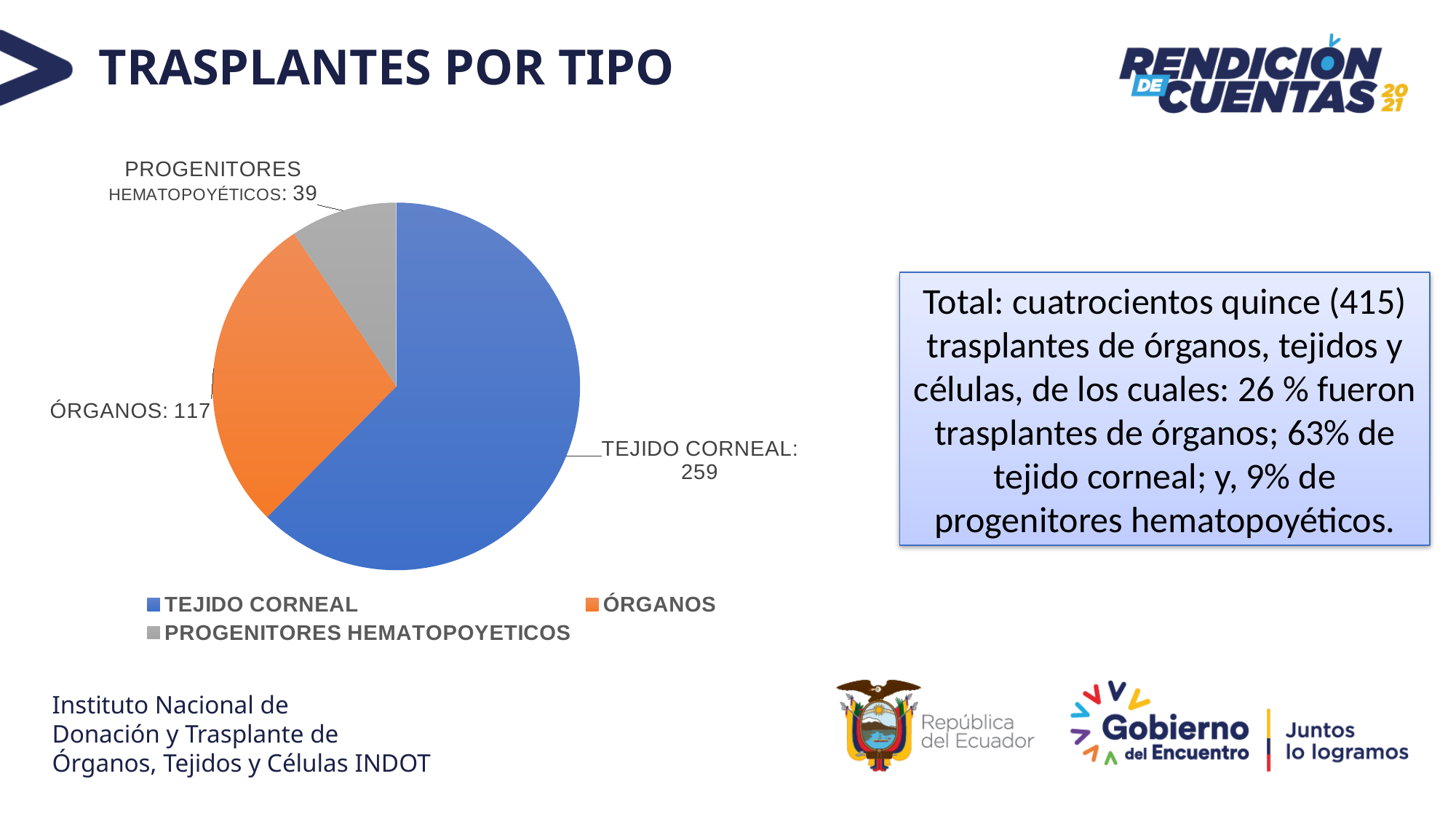
Which category has the largest slice in the pie chart? TEJIDO CORNEAL Which category has the smallest slice in the pie chart? PROGENITORES HEMATOPOYÉTICOS How many categories does the pie chart have? 3 How many transplants of TEJIDO CORNEAL are shown in the pie chart? 259 What type of chart is shown on the slide? pie chart What is the difference between the TEJIDO CORNEAL and ÓRGANOS values? 142 Which is larger, ÓRGANOS or PROGENITORES HEMATOPOYÉTICOS? ÓRGANOS What share of the pie does TEJIDO CORNEAL represent, according to the text box on the slide? 63% What colour is the ÓRGANOS slice in the pie chart? orange What is the total of all slices in the pie chart? 415 What is the value for PROGENITORES HEMATOPOYÉTICOS in the pie chart? 39 What is the value for ÓRGANOS in the pie chart? 117